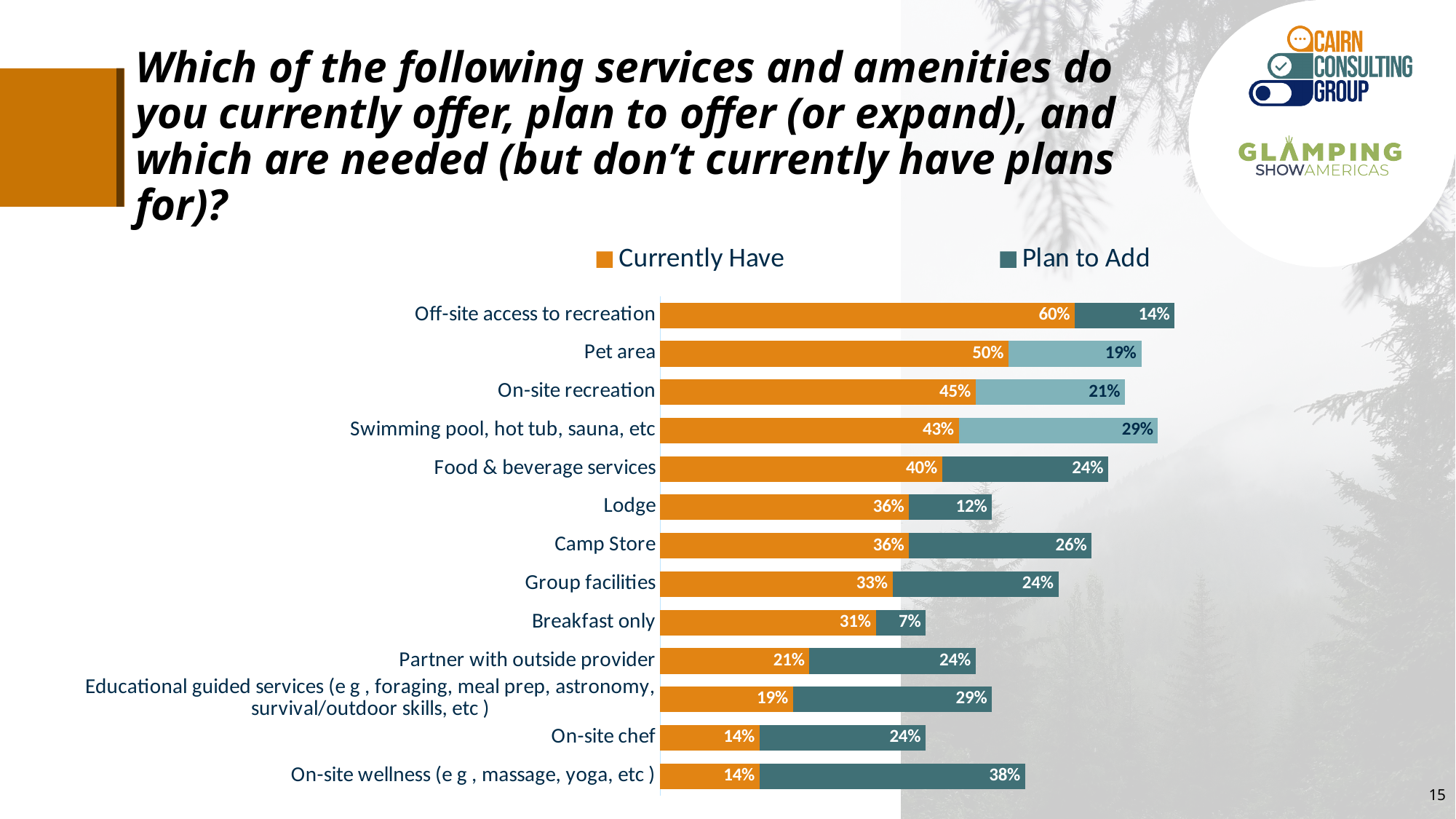
Which category has the highest Plan to Add value? On-site wellness (e g , massage, yoga, etc ) How many series does the legend list? 2 Which is larger for Camp Store: the Currently Have value or the Plan to Add value? Currently Have What type of chart is shown on the slide? Stacked bar chart What is the difference between the Currently Have and Plan to Add values for Lodge? 24% How many categories are shown in the chart? 13 What is the Currently Have value for Food & beverage services? 40% What is the Plan to Add value for On-site wellness (e g , massage, yoga, etc )? 38% What percentage of respondents currently have a pet area? 50% Which category has the lowest Plan to Add value? Breakfast only Which category has the highest Currently Have value? Off-site access to recreation What is the combined total of Currently Have and Plan to Add for Swimming pool, hot tub, sauna, etc? 72%